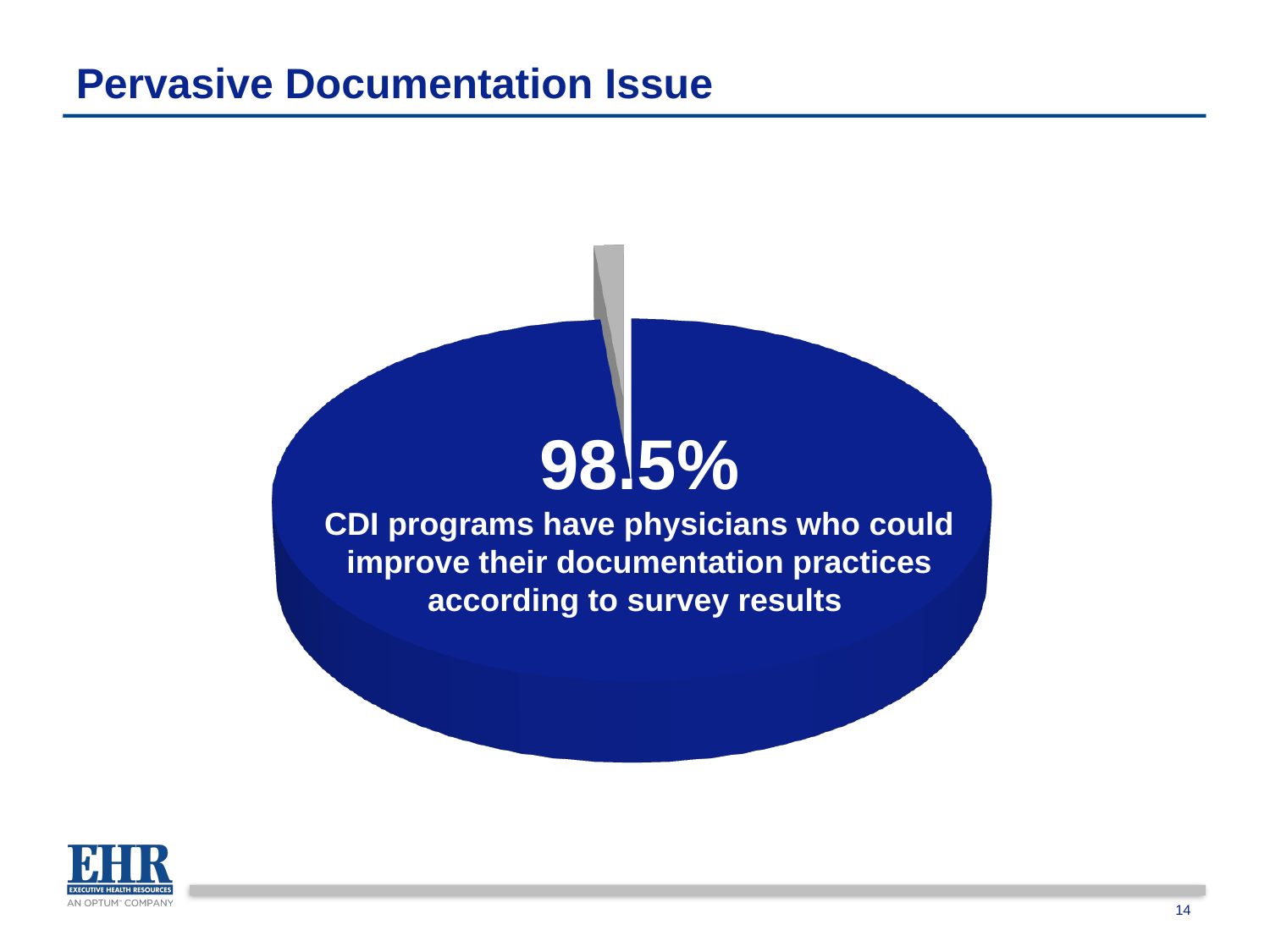
What colour is the slice representing 98.5% of the pie? blue Is the blue slice larger or smaller than the grey slice? larger What share of the pie does the large blue slice represent? 98.5% What share of the pie does the small grey slice represent, given the blue slice is 98.5%? 1.5% Which slice of the pie is the smallest, the blue one or the grey one? the grey one Which slice of the pie is the largest, the blue one or the grey one? the blue one What is the title of the slide containing the pie chart? Pervasive Documentation Issue How many slices does the pie chart have? 2 What kind of chart is shown on the slide? pie chart What percentage is printed on the pie chart? 98.5%